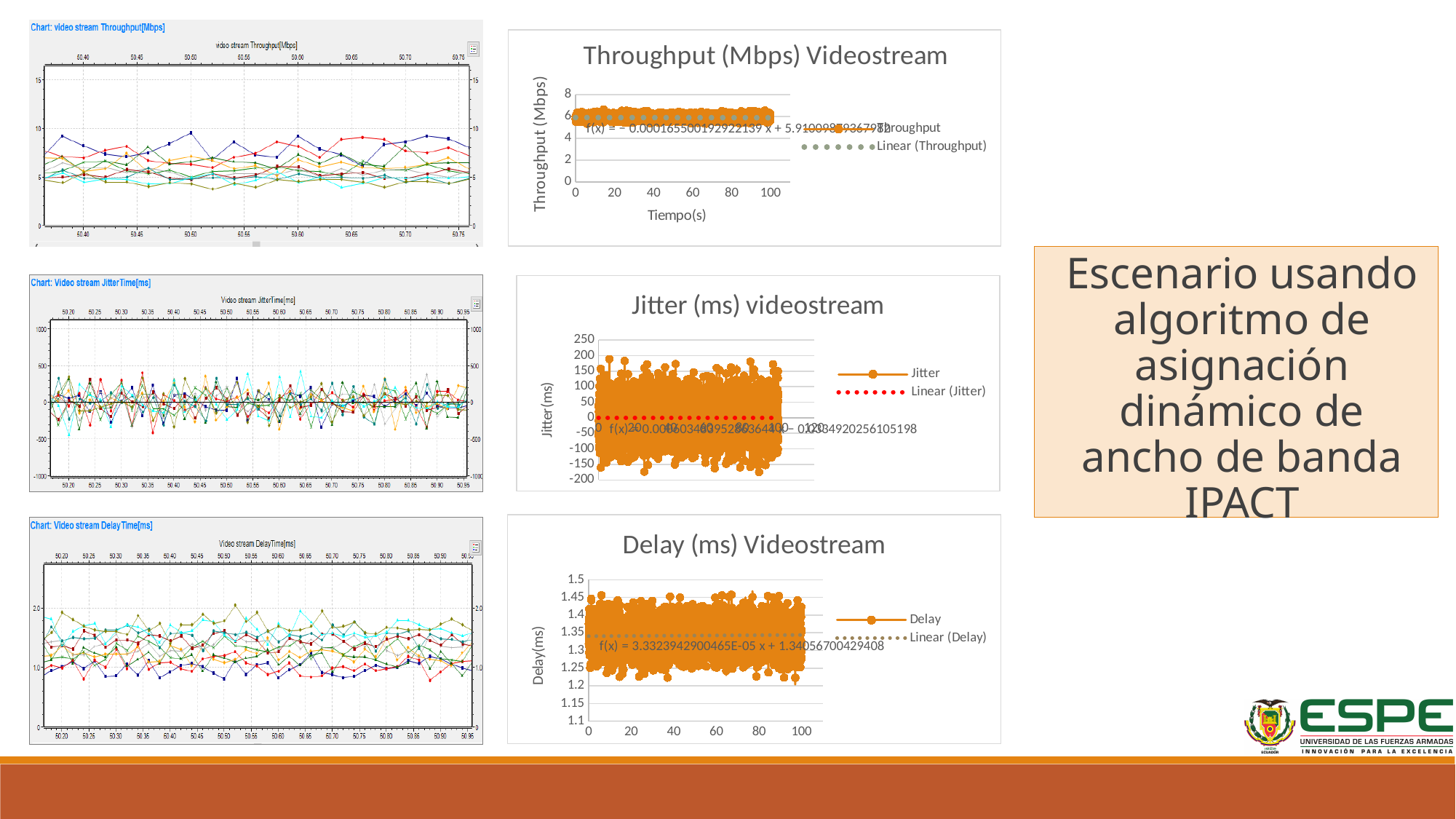
In the chart titled "Throughput (Mbps) Videostream", what is the label of the x axis? Tiempo(s) In the chart titled "Delay (ms) Videostream", are the plotted delay values greater or less than 1.5? less In the chart titled "Jitter (ms) videostream", are the plotted jitter values greater or less than 250? less In the chart titled "Jitter (ms) videostream", what is the highest value shown on the y axis? 250 In the chart titled "Throughput (Mbps) Videostream", what are the two legend entries? Throughput and Linear (Throughput) In the chart titled "Delay (ms) Videostream", are the plotted delay values greater or less than 1.1? greater In the chart titled "Delay (ms) Videostream", what is the trend line equation printed on the chart? f(x) = 3.3323942900465E-05 x + 1.34056700429408 In the chart titled "Delay (ms) Videostream", how many series does the legend list? 2 In the chart titled "Throughput (Mbps) Videostream", how many series does the legend list? 2 In the chart titled "Jitter (ms) videostream", how many series does the legend list? 2